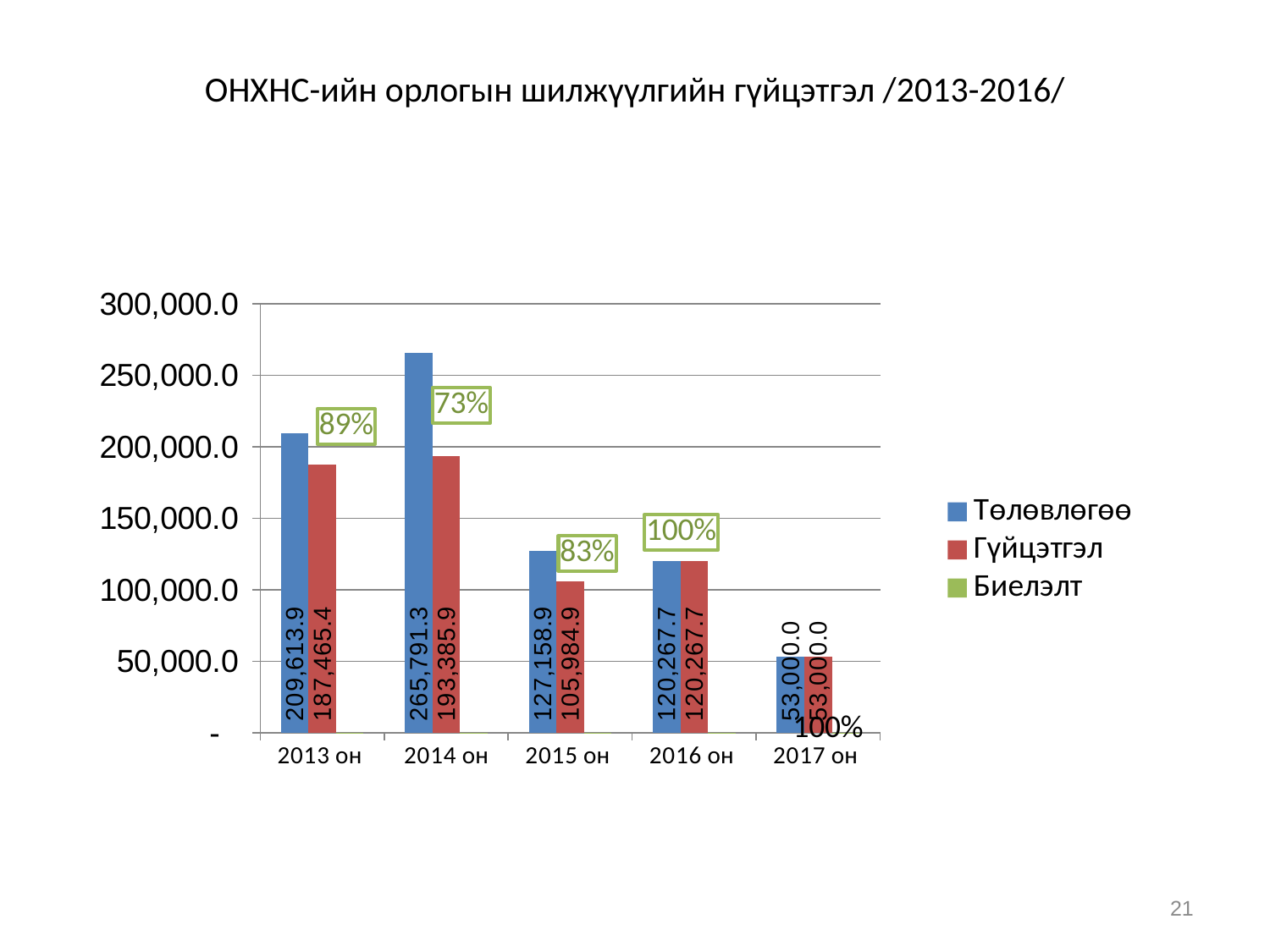
Which is larger for 2013 он, Төлөвлөгөө or Гүйцэтгэл? Төлөвлөгөө What is the Төлөвлөгөө value for 2014 он? 265,791.3 What is the difference between Төлөвлөгөө and Гүйцэтгэл for 2014 он? 72,405.4 What is the Биелэлт percentage shown for 2013 он? 89% How many year categories are shown on the x axis? 5 Is the Төлөвлөгөө value for 2016 он greater or less than 150,000.0? less What is the Гүйцэтгэл value for 2015 он? 105,984.9 Which year has the highest Төлөвлөгөө value? 2014 он Which year has the lowest Гүйцэтгэл value? 2017 он What type of chart is shown on the slide? Bar chart How many series does the legend list? 3 What colour represents the Гүйцэтгэл series in the legend? Red